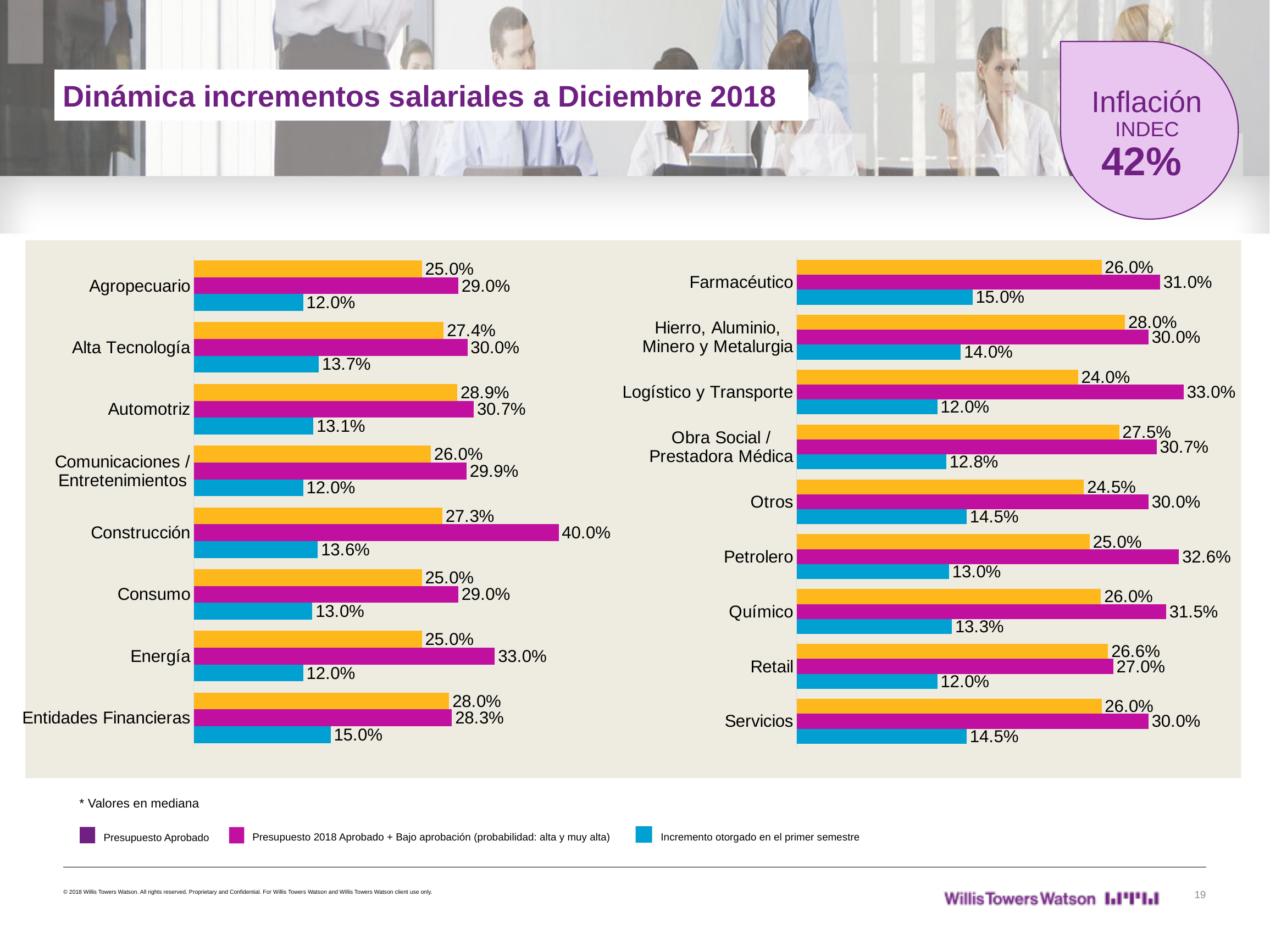
In the right chart, what is the value of 'Presupuesto 2018 Aprobado + Bajo aprobación' for Logístico y Transporte? 33.0% In the left chart, which has the larger 'Presupuesto 2018 Aprobado + Bajo aprobación' value, Energía or Consumo? Energía How many categories are shown in the right chart? 9 What type of chart is used on this slide? Bar chart In the left chart, what is the value of 'Presupuesto 2018 Aprobado + Bajo aprobación' for Construcción? 40.0% In the right chart, which category has the lowest 'Presupuesto Aprobado' value? Logístico y Transporte In the left chart, what is the difference between the 'Presupuesto 2018 Aprobado + Bajo aprobación' value and the 'Presupuesto Aprobado' value for Construcción? 12.7 percentage points In the right chart, which category has the highest 'Incremento otorgado en el primer semestre' value? Farmacéutico In the left chart, which category has the highest 'Presupuesto 2018 Aprobado + Bajo aprobación' value? Construcción How many series does the legend list? 3 In the right chart, what is the 'Presupuesto Aprobado' value for Retail? 26.6% In the right chart, what is the difference between the 'Presupuesto 2018 Aprobado + Bajo aprobación' value and the 'Incremento otorgado en el primer semestre' value for Petrolero? 19.6 percentage points